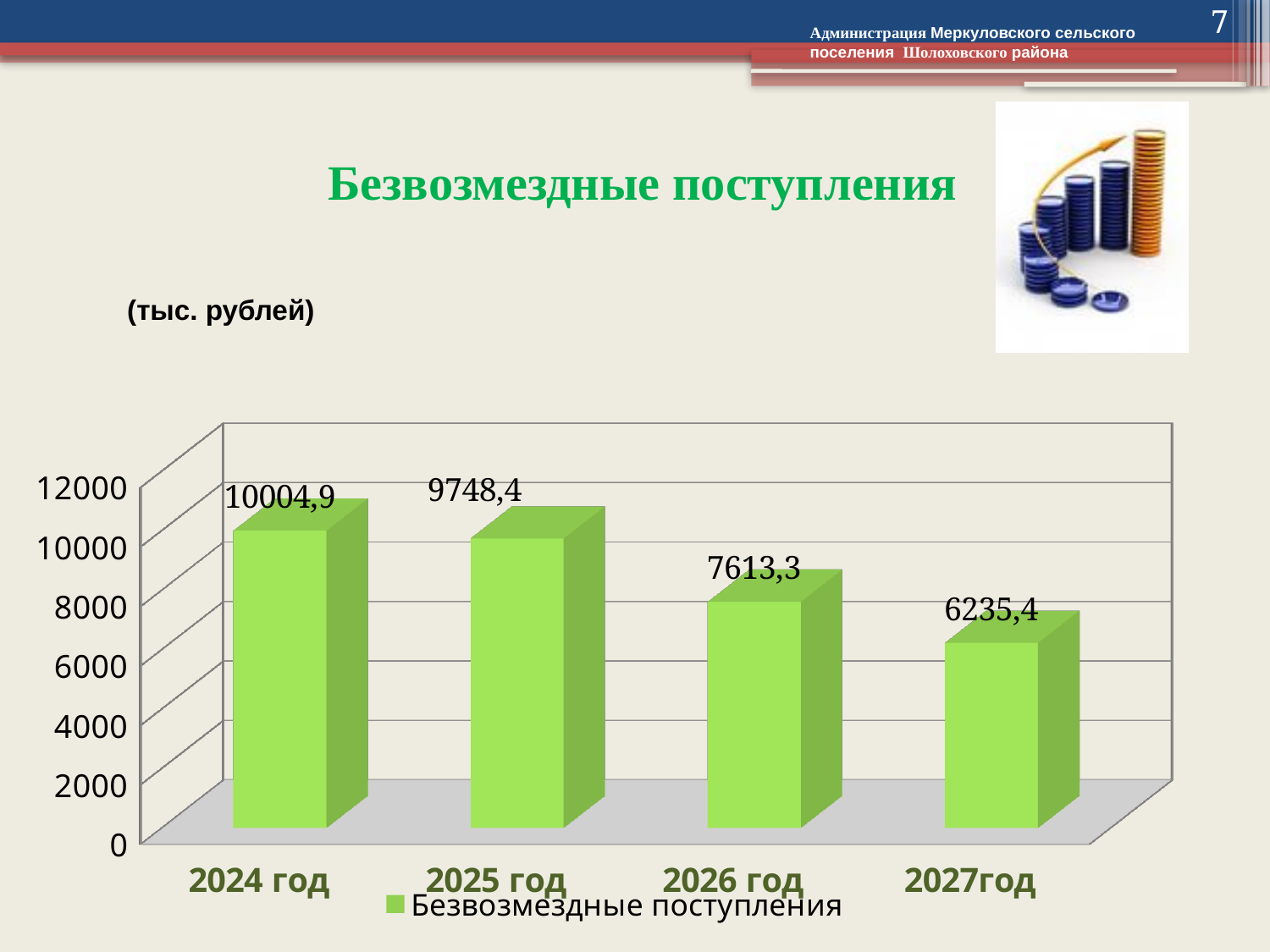
What is the value for 2024 год? 10004,9 How many years are shown on the x axis? 4 Is the value for 2027год greater or less than 8000? less What is the value for 2027год? 6235,4 What kind of chart is shown on the slide? bar chart What is the difference between the values for 2024 год and 2027год? 3769,5 Do the values rise or fall from 2024 год to 2027год? fall What is the value for 2026 год? 7613,3 What is the difference between the values for 2025 год and 2026 год? 2135,1 Which year has the lowest value? 2027год Which year has the highest value? 2024 год Which is larger, the value for 2025 год or the value for 2026 год? 2025 год